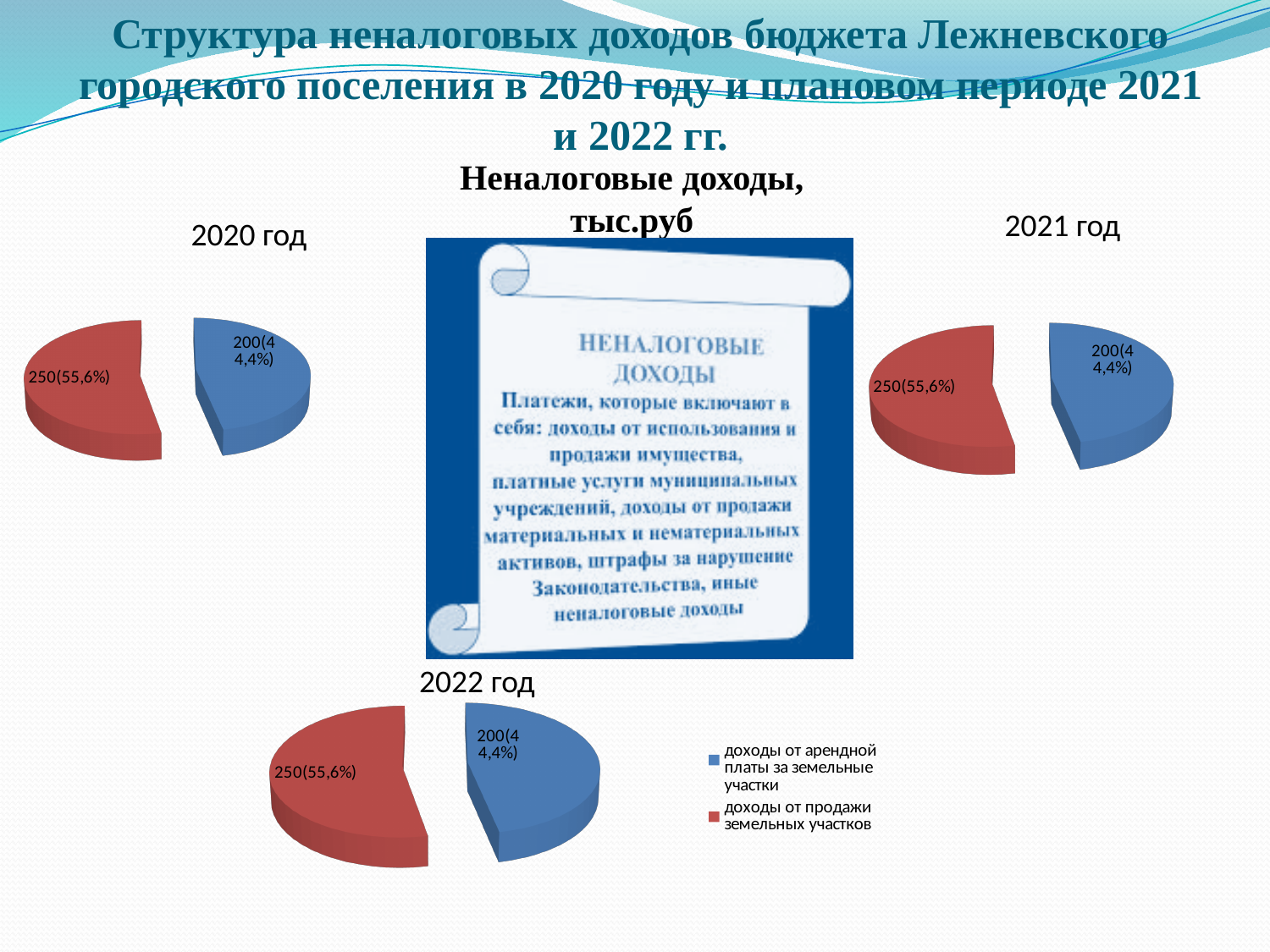
On the 2022 год chart, which category is the smallest? доходы от арендной платы за земельные участки What kind of chart is the 2022 год chart? pie chart On the 2021 год chart, what is the value for доходы от арендной платы за земельные участки? 200 On the 2020 год chart, what share of the pie is доходы от арендной платы за земельные участки? 44,4% On the 2021 год chart, which is larger: доходы от арендной платы за земельные участки or доходы от продажи земельных участков? доходы от продажи земельных участков On the 2022 год chart, what is the difference between доходы от продажи земельных участков and доходы от арендной платы за земельные участки? 50 What colour is the доходы от продажи земельных участков slice in the legend? red On the 2021 год chart, what share of the pie is доходы от продажи земельных участков? 55,6% On the 2020 год chart, what is the value for доходы от продажи земельных участков? 250 On the 2020 год chart, what is the total of the two slices? 450 How many slices does the 2020 год chart have? 2 On the 2022 год chart, which category is the largest? доходы от продажи земельных участков